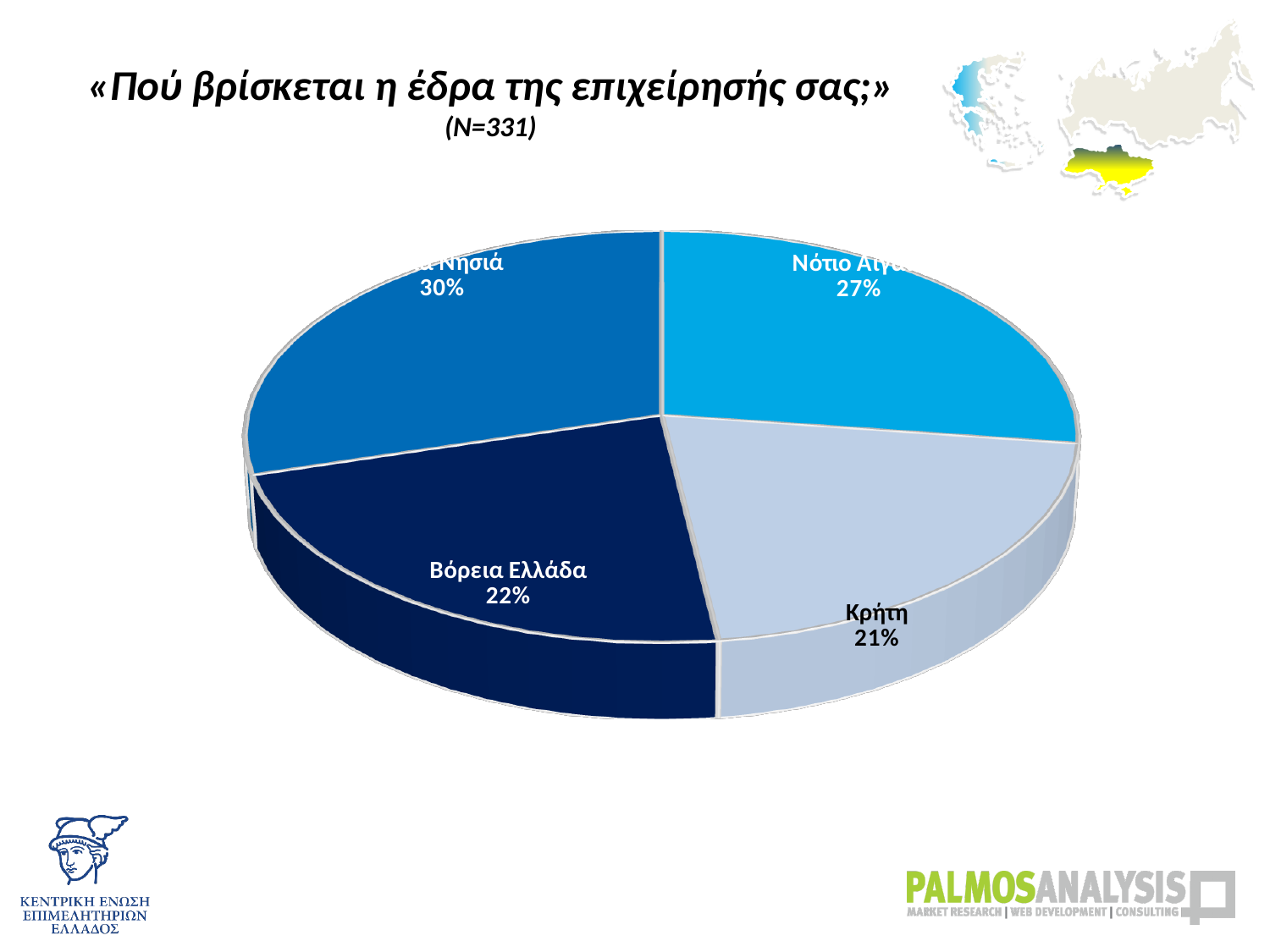
What is the largest percentage shown on the pie chart? 30% What sample size (N) is stated under the chart title? N=331 Which has the larger share, Βόρεια Ελλάδα or Κρήτη? Βόρεια Ελλάδα What kind of chart is shown on the slide? Pie chart Which slice of the pie is the smallest? Κρήτη What is the title of the chart? «Πού βρίσκεται η έδρα της επιχείρησής σας;» What share of the pie does Κρήτη have? 21% What share of the pie does Βόρεια Ελλάδα have? 22% What is the difference in percentage points between Βόρεια Ελλάδα and Κρήτη? 1 percentage point What is the combined share of Βόρεια Ελλάδα and Κρήτη? 43% What is the difference in percentage points between the largest slice (30%) and Κρήτη? 9 percentage points How many slices does the pie chart have? 4